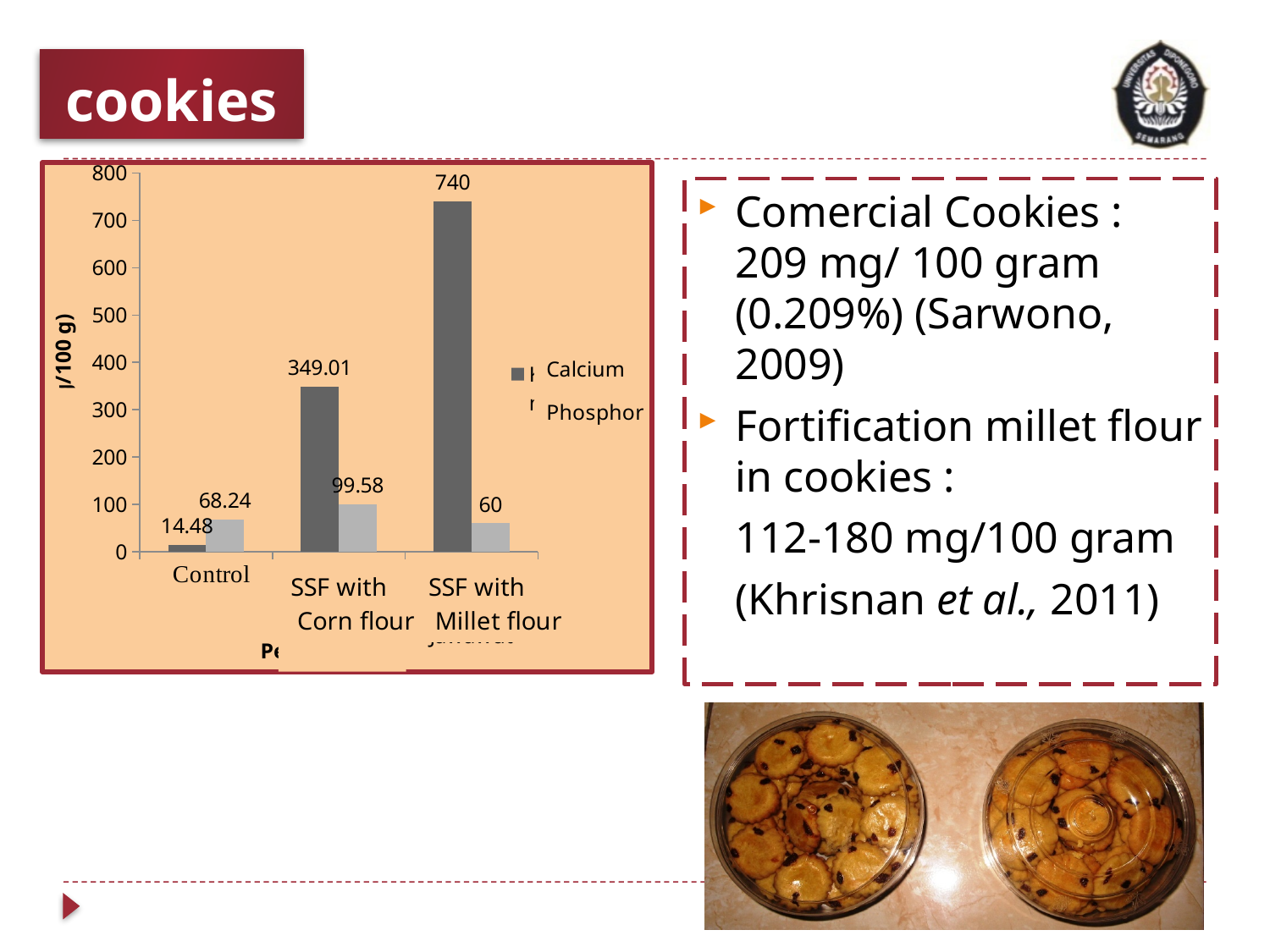
What kind of chart is shown on the slide? Bar chart What is the Phosphor value for the Control category? 68.24 What is the Phosphor value for SSF with Millet flour? 60 Which category has the lowest Calcium value? Control What is the difference between the Calcium values for SSF with Millet flour and SSF with Corn flour? 390.99 What is the Calcium value for SSF with Corn flour? 349.01 How many categories are shown on the x axis? 3 How many series does the legend list? 2 Which category has the highest Phosphor value? SSF with Corn flour What is the Calcium value for SSF with Millet flour? 740 Which category has the highest Calcium value? SSF with Millet flour Which is larger for the Control category, Calcium or Phosphor? Phosphor